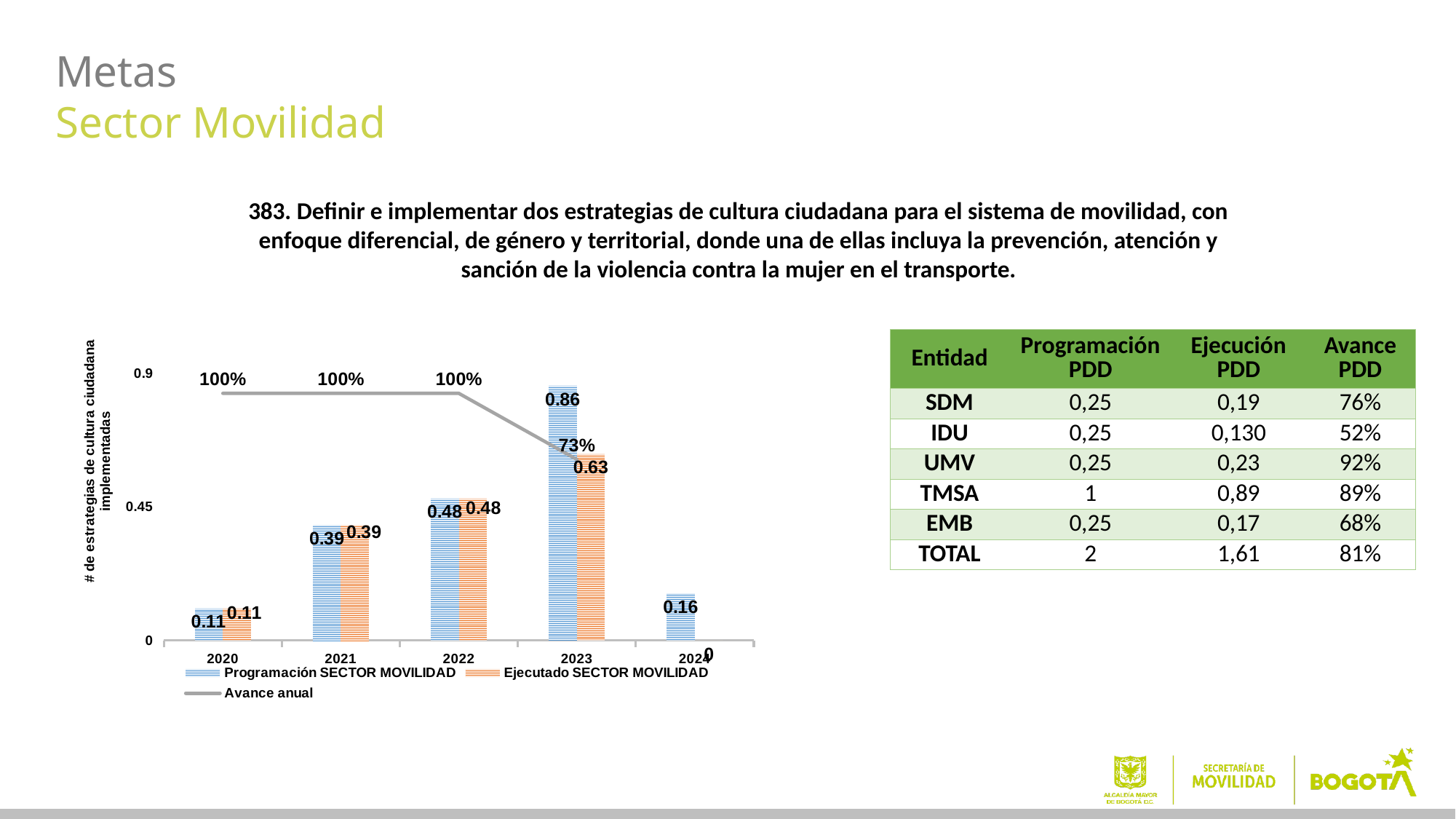
How many years are shown on the x axis of the chart? 5 Which year has the lowest Programación SECTOR MOVILIDAD value? 2020 What is the Ejecutado SECTOR MOVILIDAD value for 2023? 0.63 What is the Programación SECTOR MOVILIDAD value for 2024? 0.16 What kind of chart is used to show the Programación and Ejecutado SECTOR MOVILIDAD values? Bar chart What is the Avance anual value shown for 2023? 73% What is the difference between the Programación and Ejecutado SECTOR MOVILIDAD values in 2023? 0.23 Which is larger in 2023, the Programación SECTOR MOVILIDAD value or the Ejecutado SECTOR MOVILIDAD value? Programación SECTOR MOVILIDAD What is the Programación SECTOR MOVILIDAD value for 2023? 0.86 Which year has the highest Programación SECTOR MOVILIDAD value? 2023 How many series does the chart legend list? 3 Is the Programación SECTOR MOVILIDAD value for 2022 greater or less than 0.45? greater